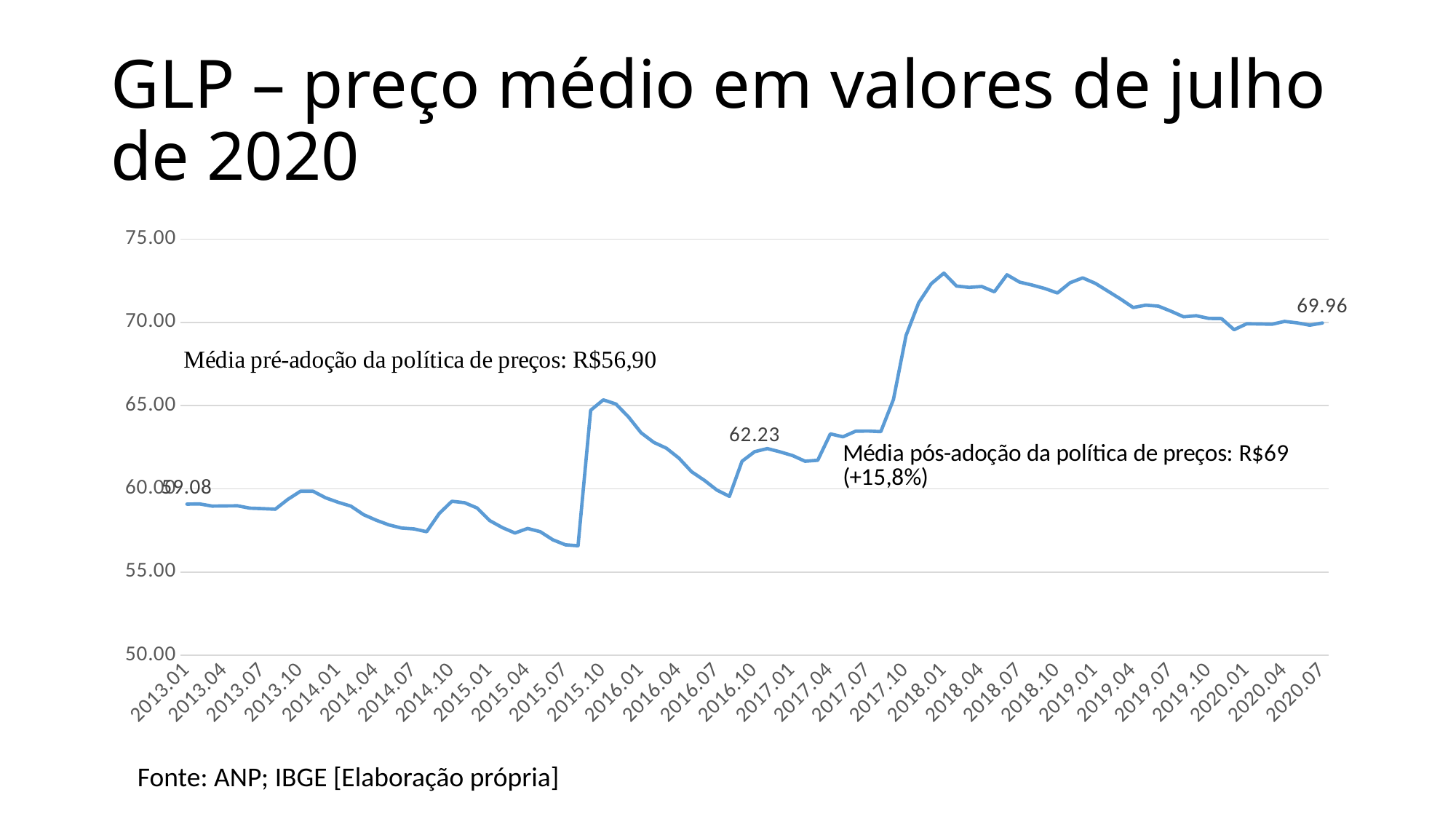
What kind of chart is shown on the slide? line chart What value is labelled on the line between 2016.07 and 2017.01? 62.23 What is the value labelled at the first point (2013.01) of the line? 59.08 What is the difference between the labelled value at 2020.07 and the labelled value at 2013.01? 10.88 According to the annotation on the chart, what was the average price before the adoption of the pricing policy? R$56,90 Is the value for 2017.01 greater or less than 65.00? less Overall, does the line rise or fall from 2013.01 to 2020.07? rise Which is larger, the value at 2020.07 or the value at 2013.01? 2020.07 Is the value for 2018.01 greater or less than 70.00? greater What is the value labelled at the last point (2020.07) of the line? 69.96 Which is larger, the value at 2018.01 or the value at 2015.07? 2018.01 Is the value for 2015.07 greater or less than 60.00? less